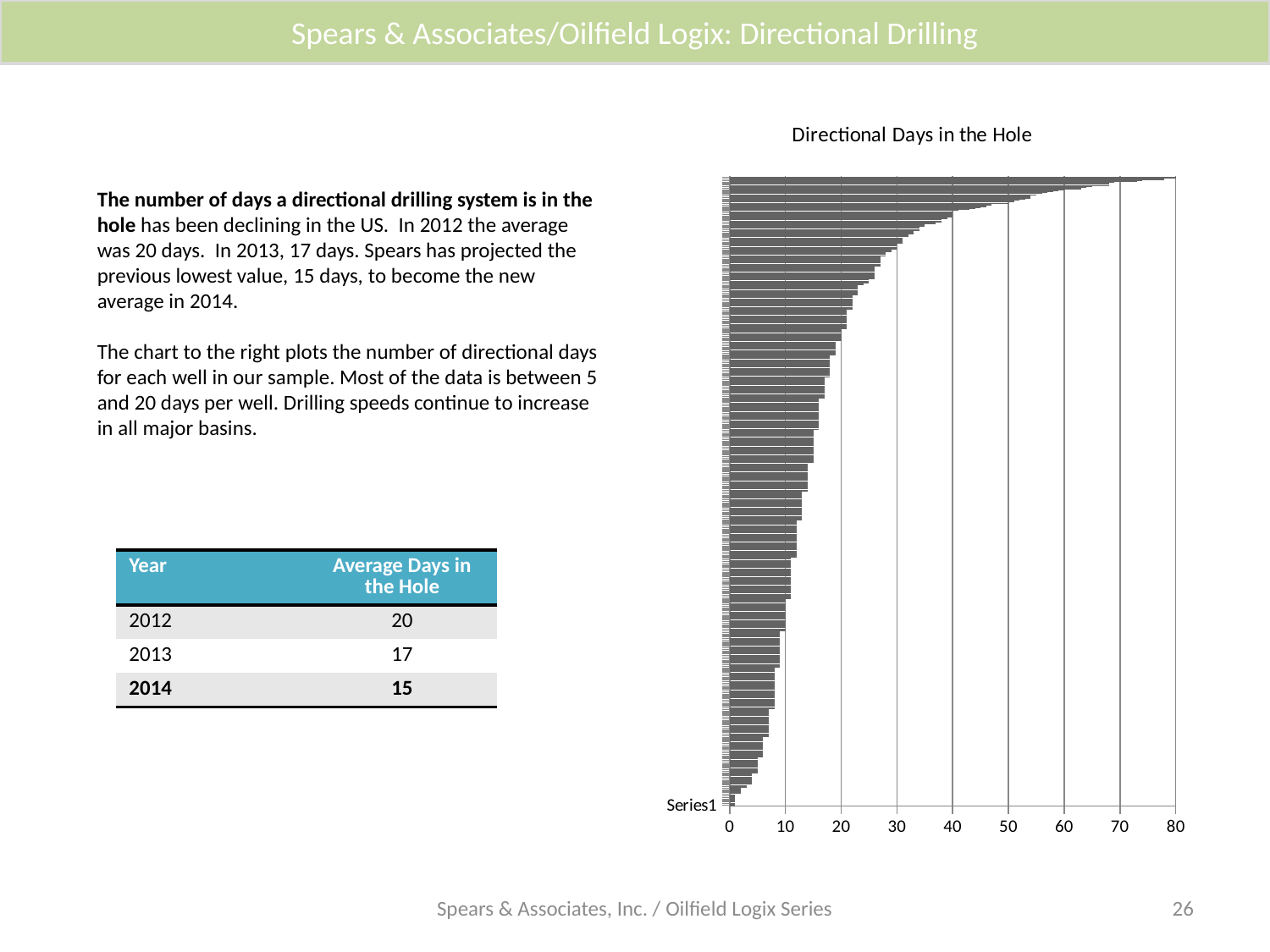
Are most of the bars in the chart greater or less than 30? less Is the value of the shortest bar in the chart greater or less than 10? less What is the title of the chart on the right of the slide? Directional Days in the Hole Is the value of the longest bar in the chart greater or less than 70? greater Do the bar lengths in the chart increase or decrease going from the top bar to the bottom bar? decrease What kind of chart is shown on the slide? bar chart What is the highest value shown on the horizontal axis of the chart? 80